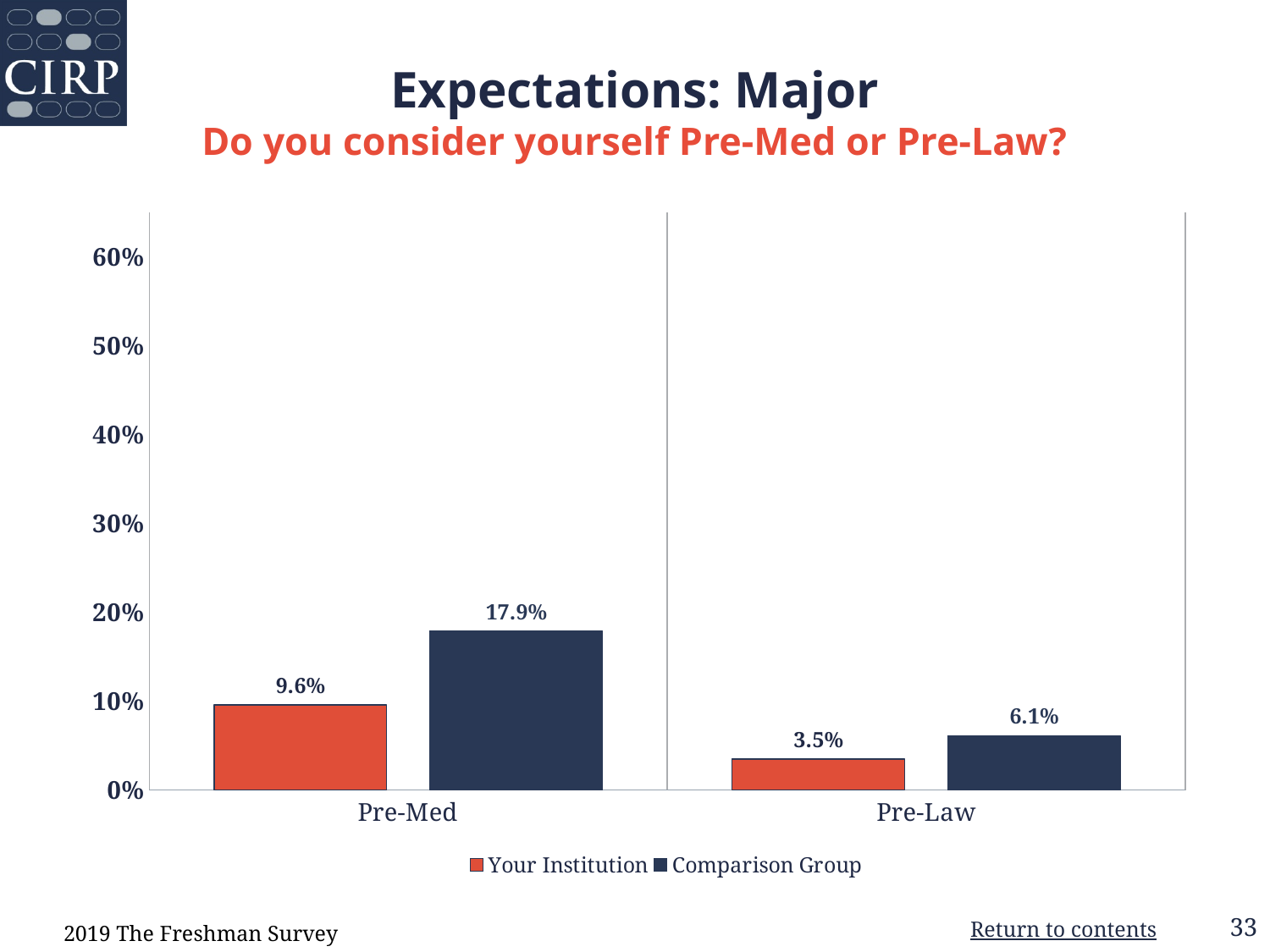
What is the difference between the Comparison Group and Your Institution values for Pre-Med? 8.3% Which bar on the chart has the highest value? Comparison Group, Pre-Med How many categories are shown on the x axis? 2 What percentage of students at Your Institution consider themselves Pre-Med? 9.6% What is the difference between the Comparison Group and Your Institution values for Pre-Law? 2.6% What is the Comparison Group value for Pre-Med? 17.9% What is the Your Institution value for Pre-Law? 3.5% For Pre-Law, which is larger: Your Institution or Comparison Group? Comparison Group What is the Comparison Group value for Pre-Law? 6.1% What kind of chart is shown on the slide? Bar chart Which bar on the chart has the lowest value? Your Institution, Pre-Law How many series does the legend list? 2